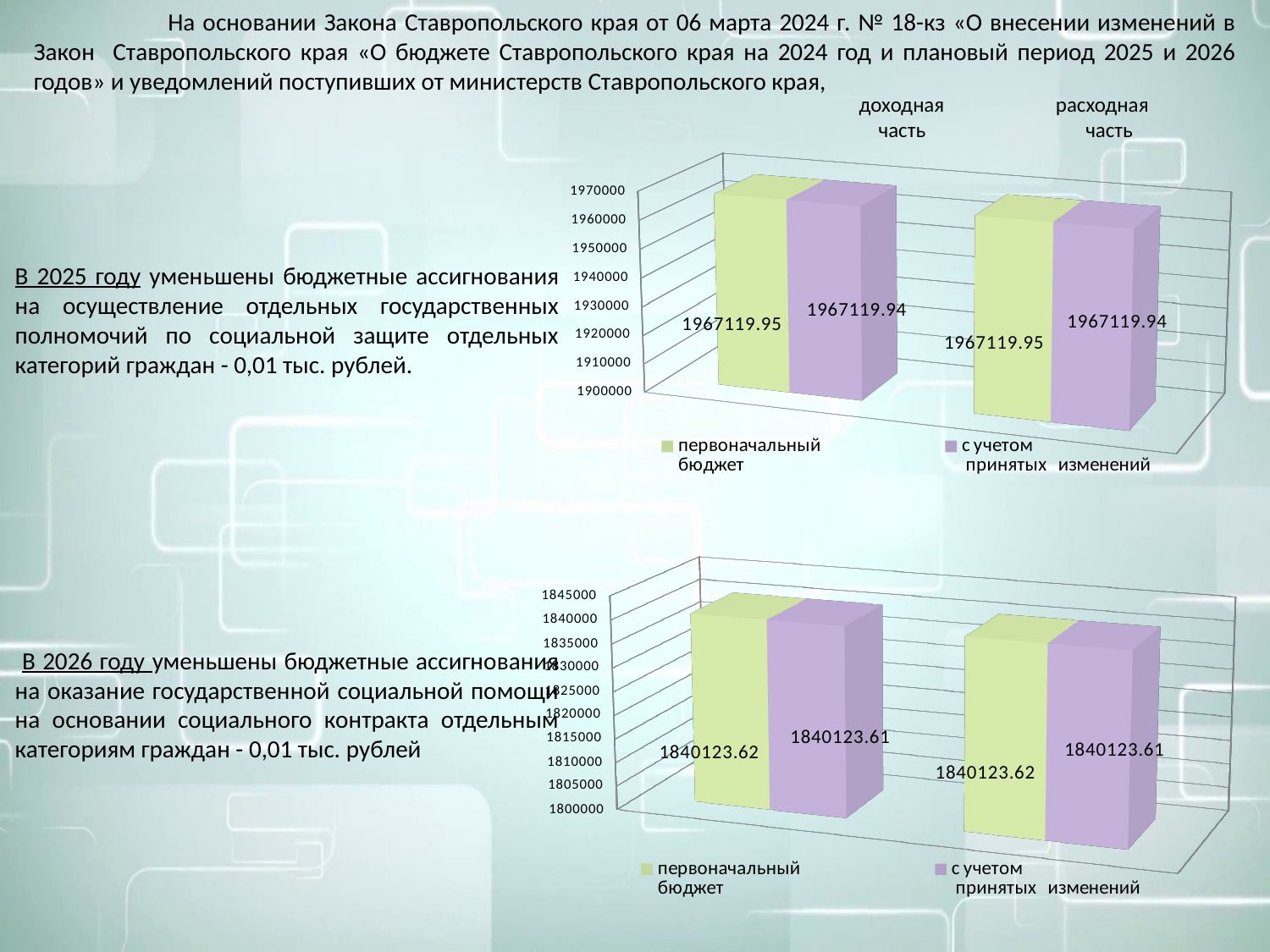
In the top chart, is the value of the 'первоначальный бюджет' bar for 'расходная часть' greater or less than 1960000? greater How many series does the legend of the top chart list? 2 In the top chart, what is the difference between the 'первоначальный бюджет' and 'с учетом принятых изменений' values for 'доходная часть'? 0.01 In the top chart, what is the value of the 'с учетом принятых изменений' bar for 'расходная часть'? 1967119.94 In the top chart, what is the value of the 'первоначальный бюджет' bar for 'доходная часть'? 1967119.95 In the bottom chart, is the value of the 'с учетом принятых изменений' bar in the left group greater or less than 1835000? greater In the bottom chart, what is the value of the 'с учетом принятых изменений' bar in the right group? 1840123.61 How many categories are shown in the top chart? 2 In the top chart, which series is shown in purple? с учетом принятых изменений In the bottom chart, what is the value of the 'первоначальный бюджет' bar in the left group? 1840123.62 What kind of chart is the bottom chart? bar chart In the bottom chart, what is the difference between the 'первоначальный бюджет' and 'с учетом принятых изменений' values in the left group? 0.01